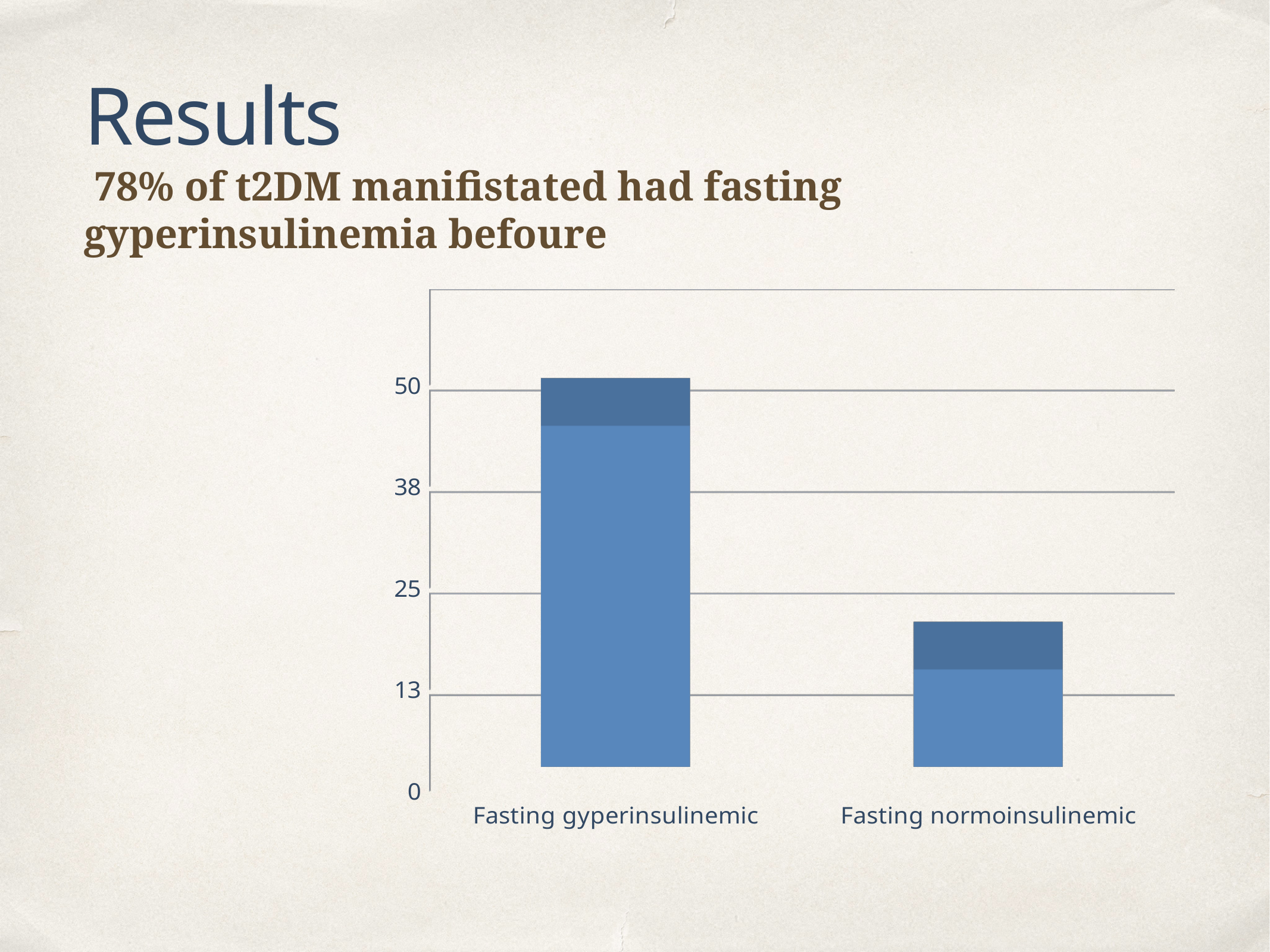
What kind of chart is shown on the slide? bar chart Do the bar values rise or fall from left to right along the x axis? fall How many categories are plotted on the x axis of the chart? 2 What is the highest tick value shown on the y axis of the chart? 50 Which category has the highest bar in the chart? Fasting gyperinsulinemic Is the value for Fasting normoinsulinemic greater or less than 25? less Which is larger, the value for Fasting gyperinsulinemic or the value for Fasting normoinsulinemic? Fasting gyperinsulinemic What is the label of the rightmost category on the x axis? Fasting normoinsulinemic Is the value for Fasting gyperinsulinemic greater or less than 38? greater Which category has the lowest bar in the chart? Fasting normoinsulinemic